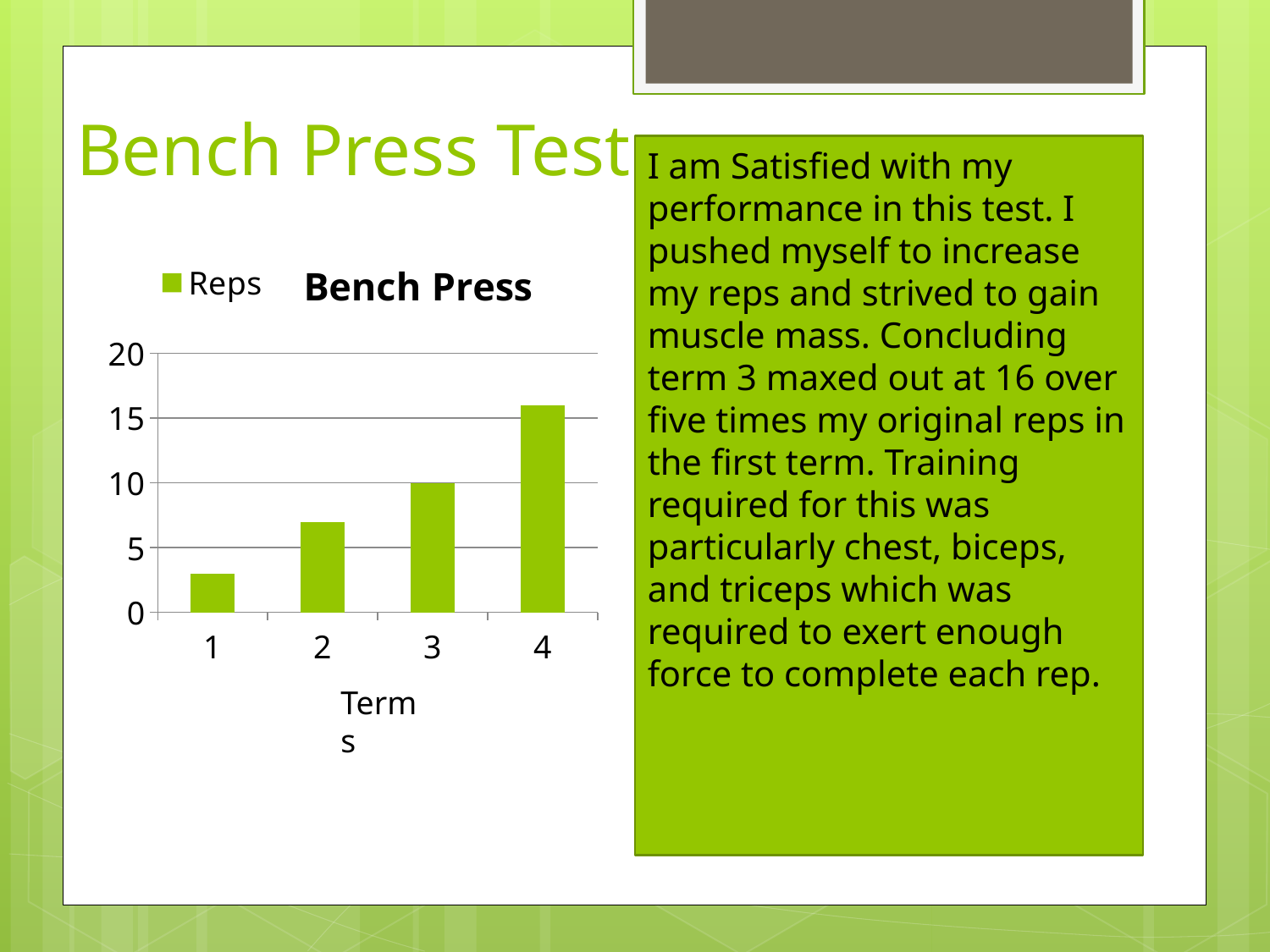
Is the value for term 1 greater or less than 5? less What is the value for term 3? 10 Which term has the lowest number of reps? 1 What kind of chart is shown on the slide? bar chart Do the reps rise or fall from term 1 to term 4? rise How many terms (categories) are plotted on the x axis? 4 What is the title of the chart? Bench Press Which term has the highest number of reps? 4 What is the name of the series shown in the legend? Reps How many series does the chart legend list? 1 Is the value for term 2 greater or less than 5? greater Which term has more reps, term 2 or term 3? 3